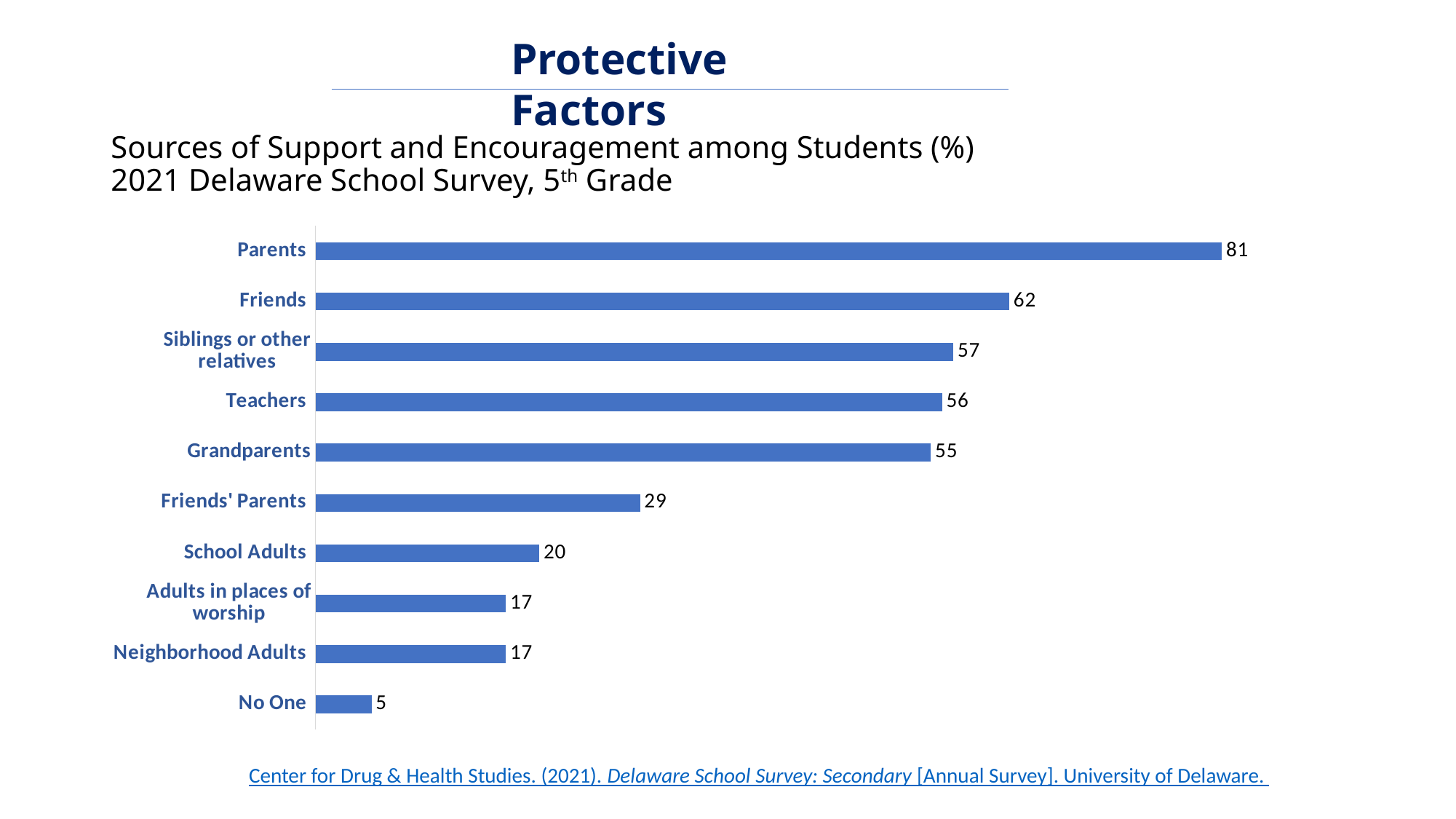
What is the title of the chart? Sources of Support and Encouragement among Students (%) 2021 Delaware School Survey, 5th Grade What is the difference between the values for School Adults and No One? 15 How many categories are shown in the chart? 10 Which is larger, the value for Friends or the value for Grandparents? Friends What is the value for Adults in places of worship? 17 What kind of chart is shown on the slide? Bar chart Do the values rise or fall going from the top bar to the bottom bar? Fall Which category has the highest value? Parents What is the difference between the values for Parents and Friends? 19 Which category has the lowest value? No One What is the value for Parents? 81 What is the value for Friends' Parents? 29